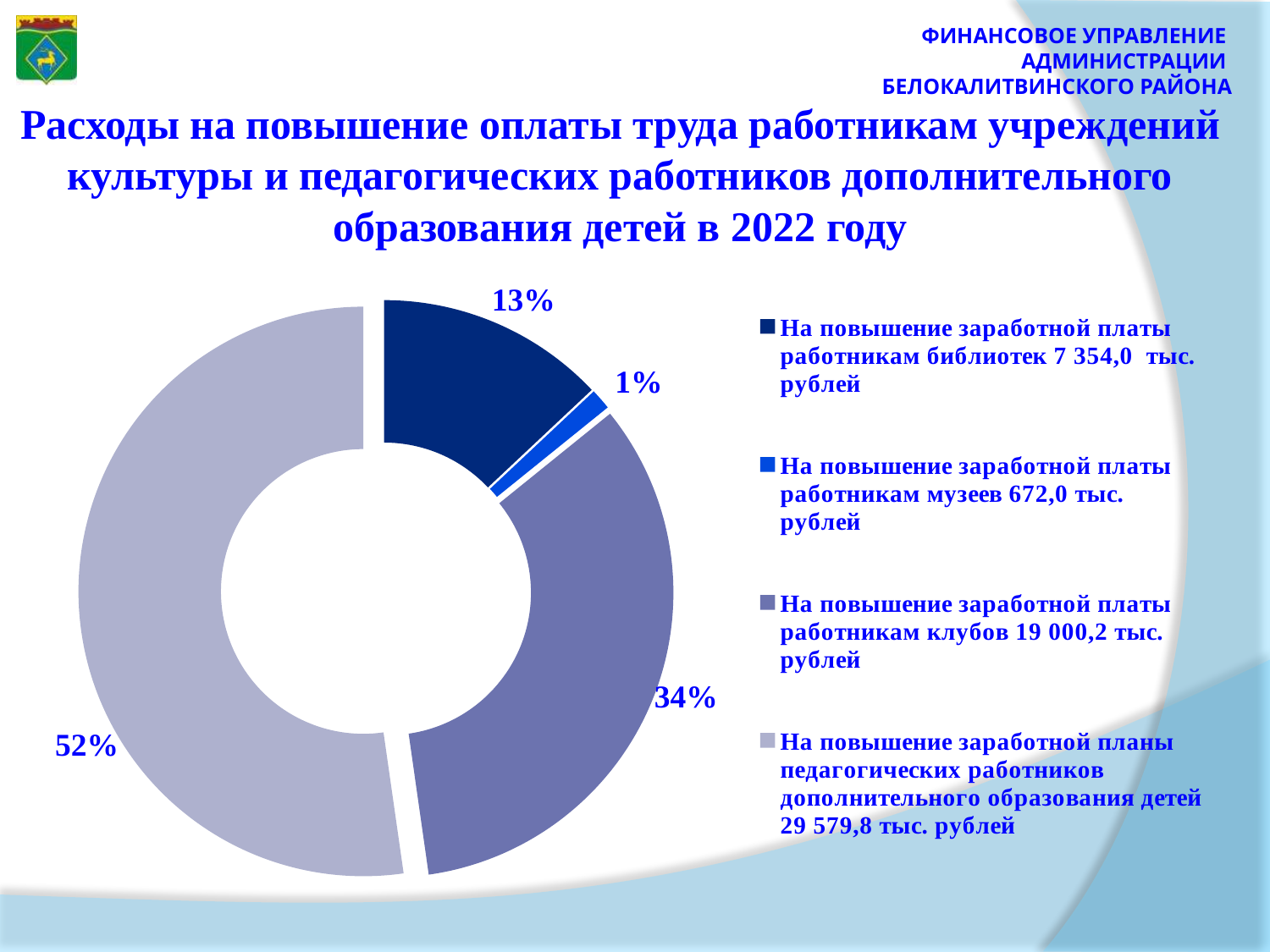
What share of the chart is for raising wages of pedagogical workers of children's additional education? 52% Which is larger: the share for library workers or the share for museum workers? Library workers (13%) What share of the chart is for raising wages of club workers (работникам клубов)? 34% What kind of chart is shown on the slide? Doughnut (pie) chart Which category has the smallest share of the chart? Museum workers (работникам музеев) How many categories does the chart show? 4 Which category has the largest share of the chart? Pedagogical workers of additional education (педагогических работников дополнительного образования детей) What share of the chart is for raising wages of library workers (работникам библиотек)? 13% What is the difference in percentage points between the share for pedagogical workers of additional education and the share for club workers? 18 percentage points According to the legend, what amount in thousand rubles is allocated for raising wages of club workers? 19 000,2 тыс. рублей According to the legend, what amount in thousand rubles is allocated for raising wages of library workers? 7 354,0 тыс. рублей